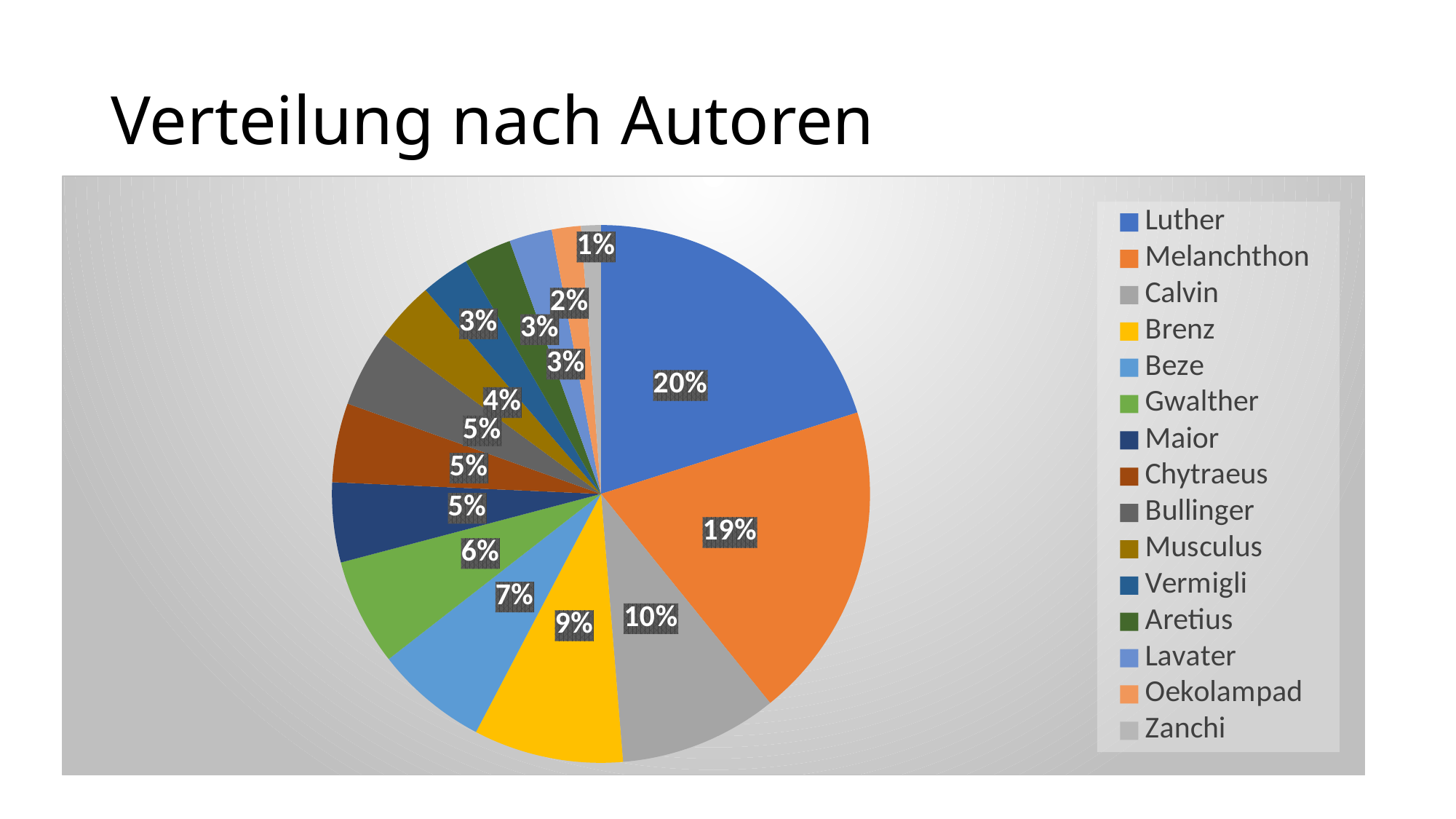
Which has the larger share, Gwalther or Beze? Beze What share of the pie does Beze have? 7% What is the difference in percentage points between Luther's share and Calvin's share? 10 Which author has the largest share of the pie? Luther What share of the pie does Brenz have? 9% What is the title of the chart? Verteilung nach Autoren Which author has the smallest share of the pie? Zanchi What share of the pie does Calvin have? 10% What share of the pie does Luther have? 20% What share of the pie does Melanchthon have? 19% How many authors does the legend list? 15 What kind of chart is shown on the slide? pie chart